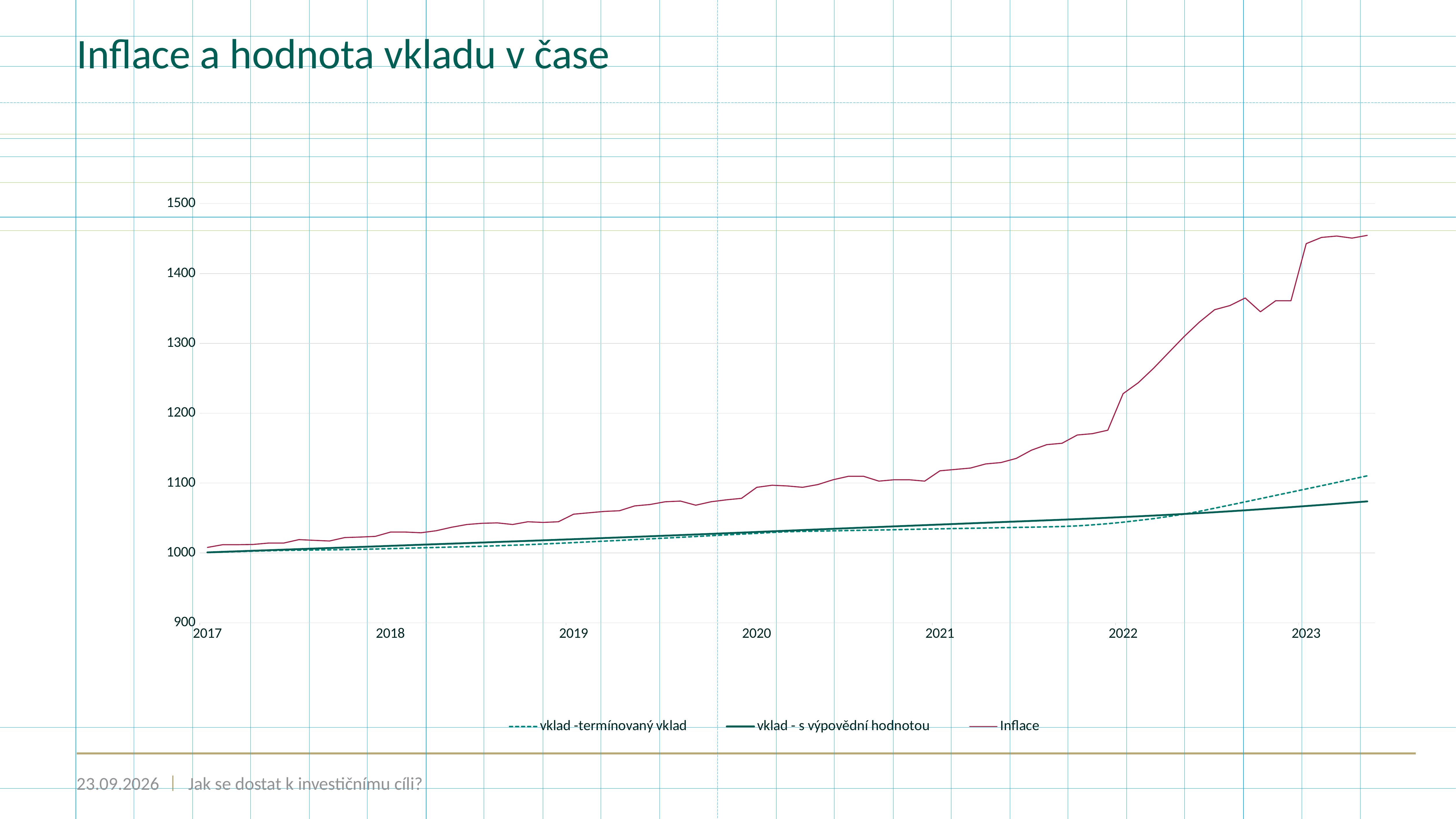
Which series reaches the highest value on the chart? Inflace Is the value of the vklad - s výpovědní hodnotou series at 2023 greater or less than 1200? less At 2023, which series has the higher value: Inflace or vklad - s výpovědní hodnotou? Inflace How many series does the chart legend list? 3 Is the value of the Inflace series at 2023 greater or less than 1400? greater What is the title of the slide chart? Inflace a hodnota vkladu v čase Which series is drawn with a dashed line? vklad -termínovaný vklad What kind of chart is shown on the slide? line chart Is the value of the Inflace series at 2017 greater or less than 1100? less How many year labels are shown on the x axis? 7 Does the Inflace series rise or fall from 2017 to 2023? rise